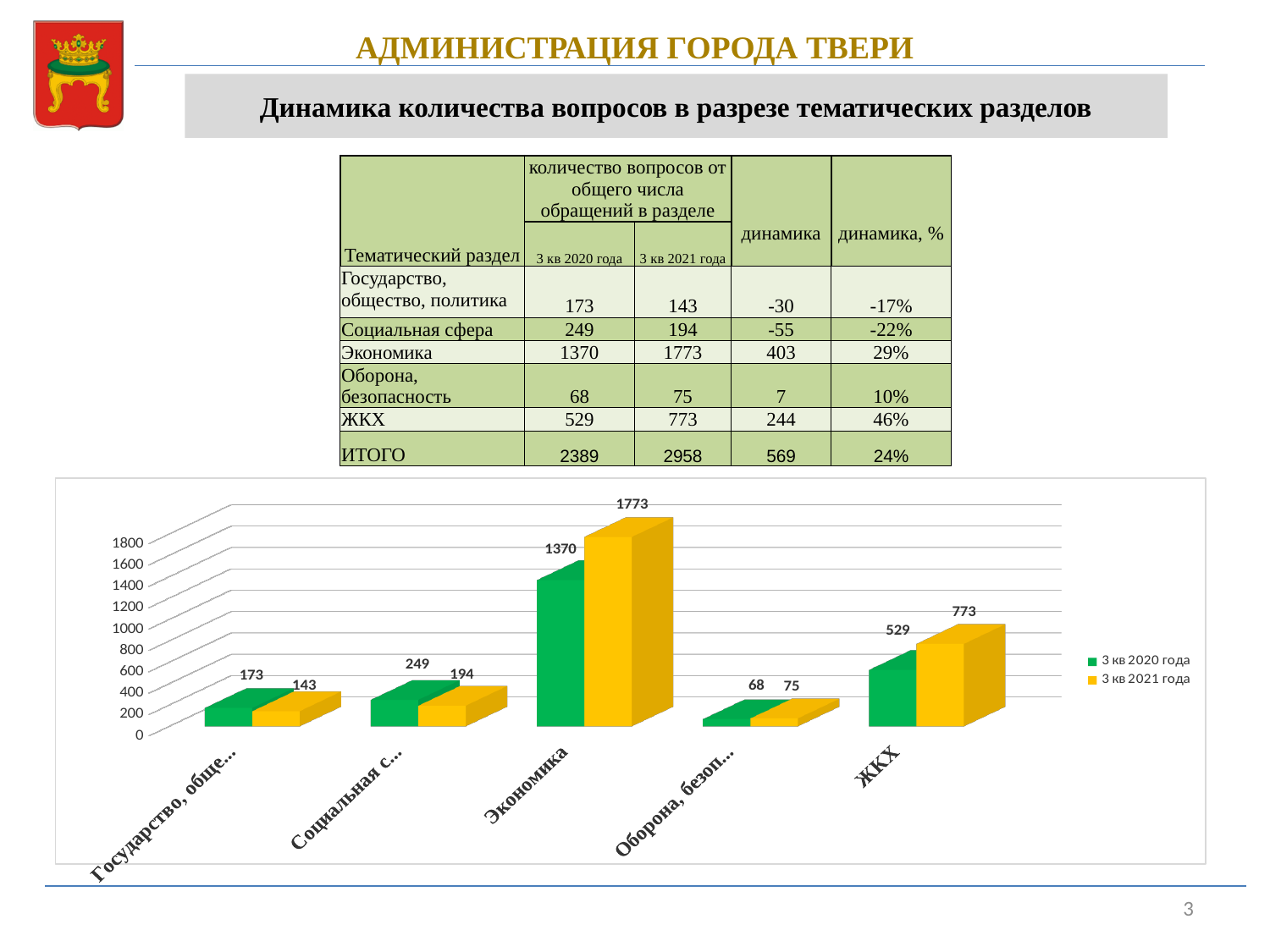
In the bar chart, which category has the highest value in the series 3 кв 2021 года? Экономика In the bar chart, what is the value for Оборона, безопасность in the series 3 кв 2021 года? 75 In the bar chart, what is the value for Экономика in the series 3 кв 2021 года? 1773 In the bar chart, which series has the larger value for Экономика: 3 кв 2020 года or 3 кв 2021 года? 3 кв 2021 года In the bar chart, which category has the lowest value in the series 3 кв 2020 года? Оборона, безопасность In the bar chart, is the value for ЖКХ in 3 кв 2021 года greater or less than 600? greater In the bar chart, what is the value for ЖКХ in the series 3 кв 2020 года? 529 In the bar chart, what is the difference between the 3 кв 2021 года and 3 кв 2020 года values for ЖКХ? 244 What kind of chart is shown on the slide? bar chart In the bar chart, what is the difference between the 3 кв 2021 года and 3 кв 2020 года values for Экономика? 403 How many categories are shown on the x axis of the bar chart? 5 How many series does the legend of the bar chart list? 2